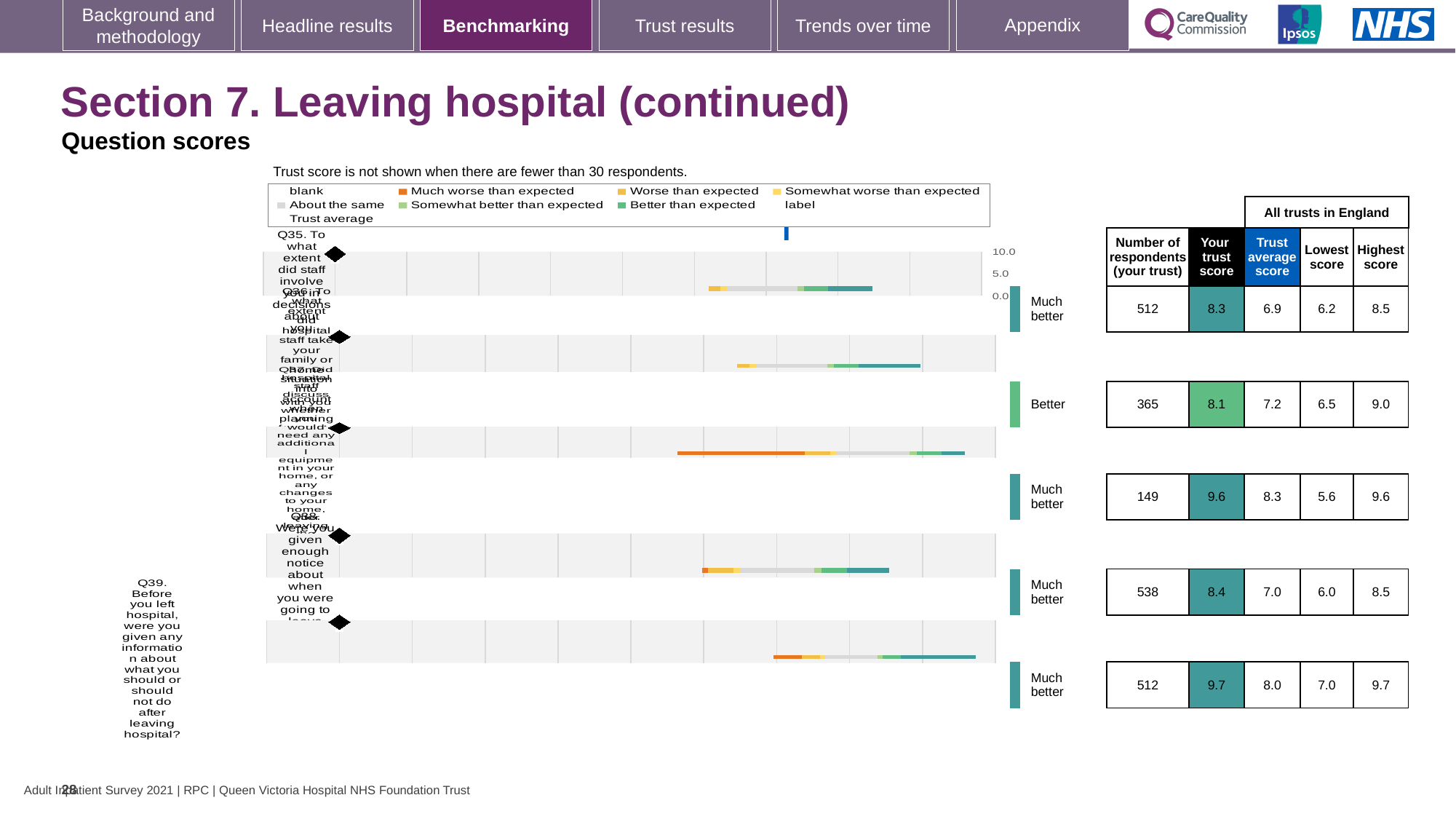
Which row of the chart is rated 'Better' rather than 'Much better'? Q36 (the second row) What colour does the legend use for 'Much worse than expected'? orange What is the lowest score across all trusts in England for the third row of the chart (Q37)? 5.6 How many respondents does the table show for the second row of the chart (Q36)? 365 Which row of the chart has the lowest 'Your trust score'? Q36 (the second row) How many questions (rows) are plotted in the question scores chart? 5 Which is larger for the fourth row of the chart (Q38): the trust score or the trust average score? the trust score (8.4) What is the difference between the trust score and the trust average score for the third row of the chart (Q37)? 1.3 What is the 'Your trust score' for the first row of the chart (Q35)? 8.3 What kind of chart is used to show the question scores on this slide? bar chart What is the 'Your trust score' for the last row of the chart (Q39, information about what you should or should not do after leaving hospital)? 9.7 Which row of the chart has the highest 'Your trust score'? Q39 (the last row)